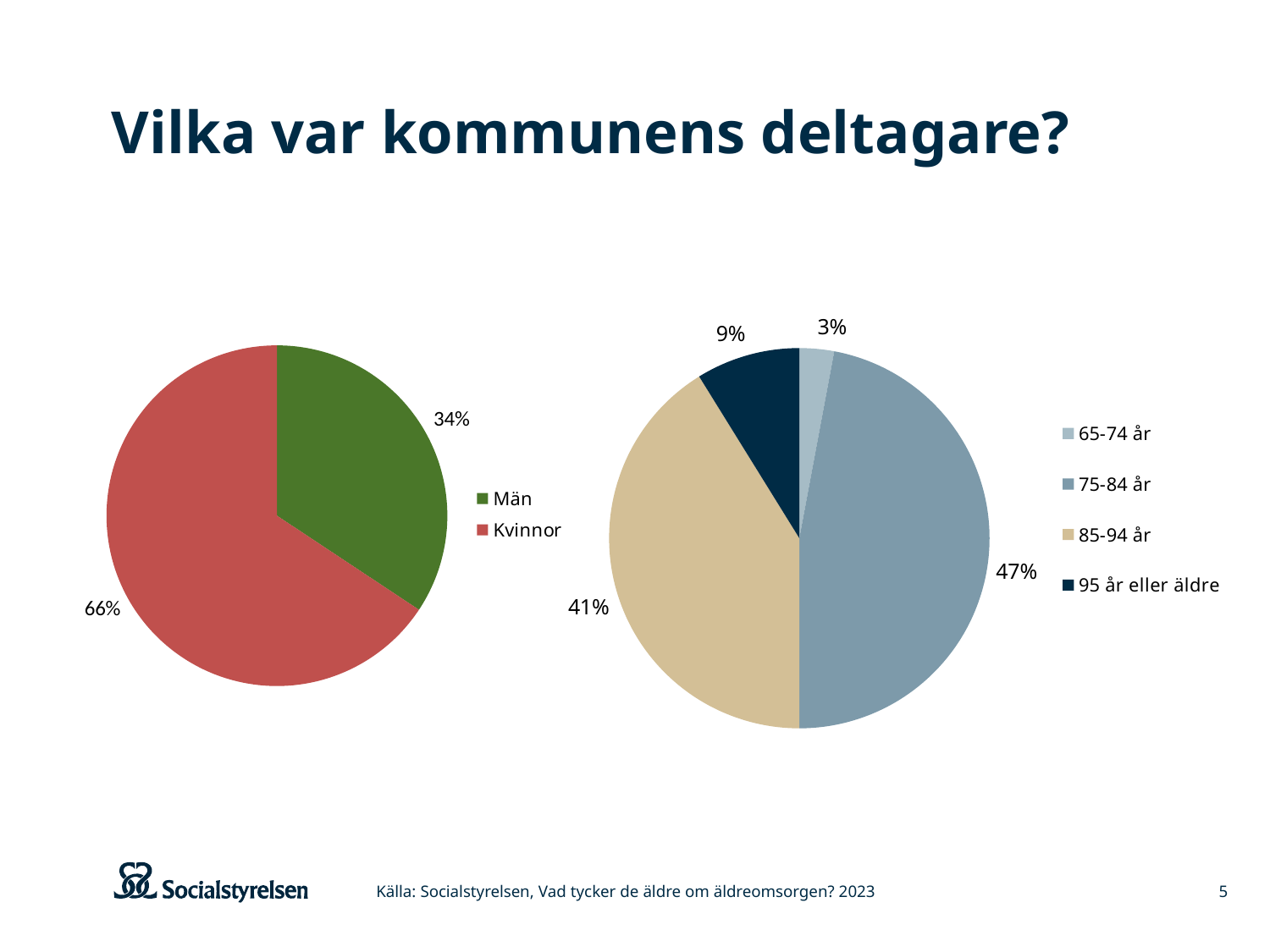
In the left pie chart (Män/Kvinnor), what share of participants are Män? 34% What type of chart is used on the right side of the slide? Pie chart In the right pie chart (age groups), what share of participants are 95 år eller äldre? 9% In the right pie chart (age groups), which age group has the largest share? 75-84 år In the left pie chart (Män/Kvinnor), what share of participants are Kvinnor? 66% In the right pie chart (age groups), how many age groups are shown? 4 In the left pie chart (Män/Kvinnor), what is the difference in percentage points between Kvinnor and Män? 32 In the left pie chart (Män/Kvinnor), which group has the larger share? Kvinnor In the right pie chart (age groups), what share of participants are 75-84 år? 47% In the right pie chart (age groups), what share of participants are 85-94 år? 41% In the right pie chart (age groups), which age group has the smallest share? 65-74 år In the left pie chart (Män/Kvinnor), how many series does the legend list? 2